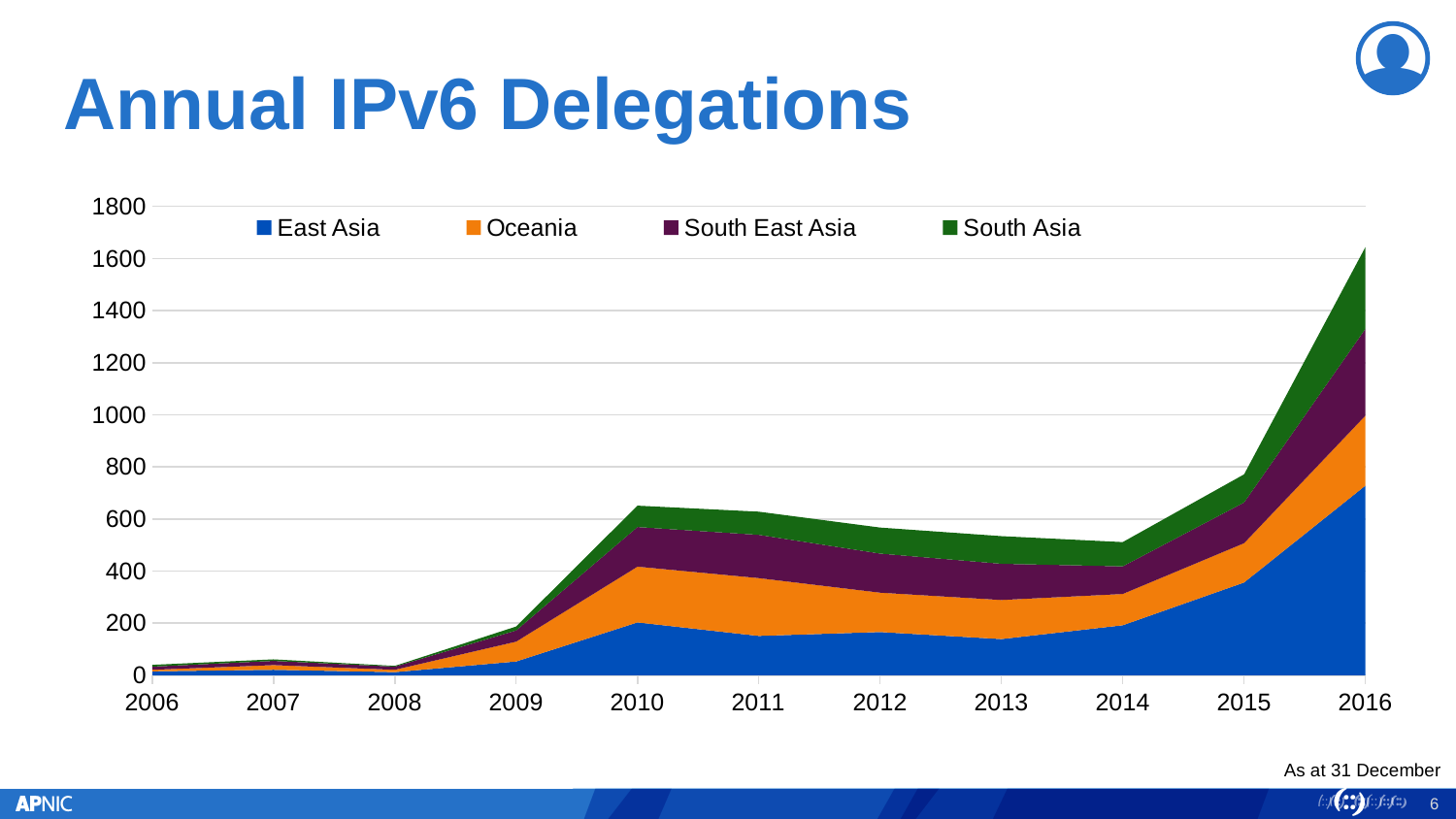
What kind of chart is shown on the slide? Stacked area chart Is the total value for 2016 greater or less than 1400? greater Is the total value for 2008 greater or less than 200? less Do the total values rise or fall from 2014 to 2016? rise Which series is shown in blue? East Asia Is the East Asia value for 2016 greater or less than 600? greater How many years are shown along the x axis? 11 How many series does the legend list? 4 Which year has the larger total, 2015 or 2016? 2016 What is the title of the chart? Annual IPv6 Delegations Which year has the highest total IPv6 delegations? 2016